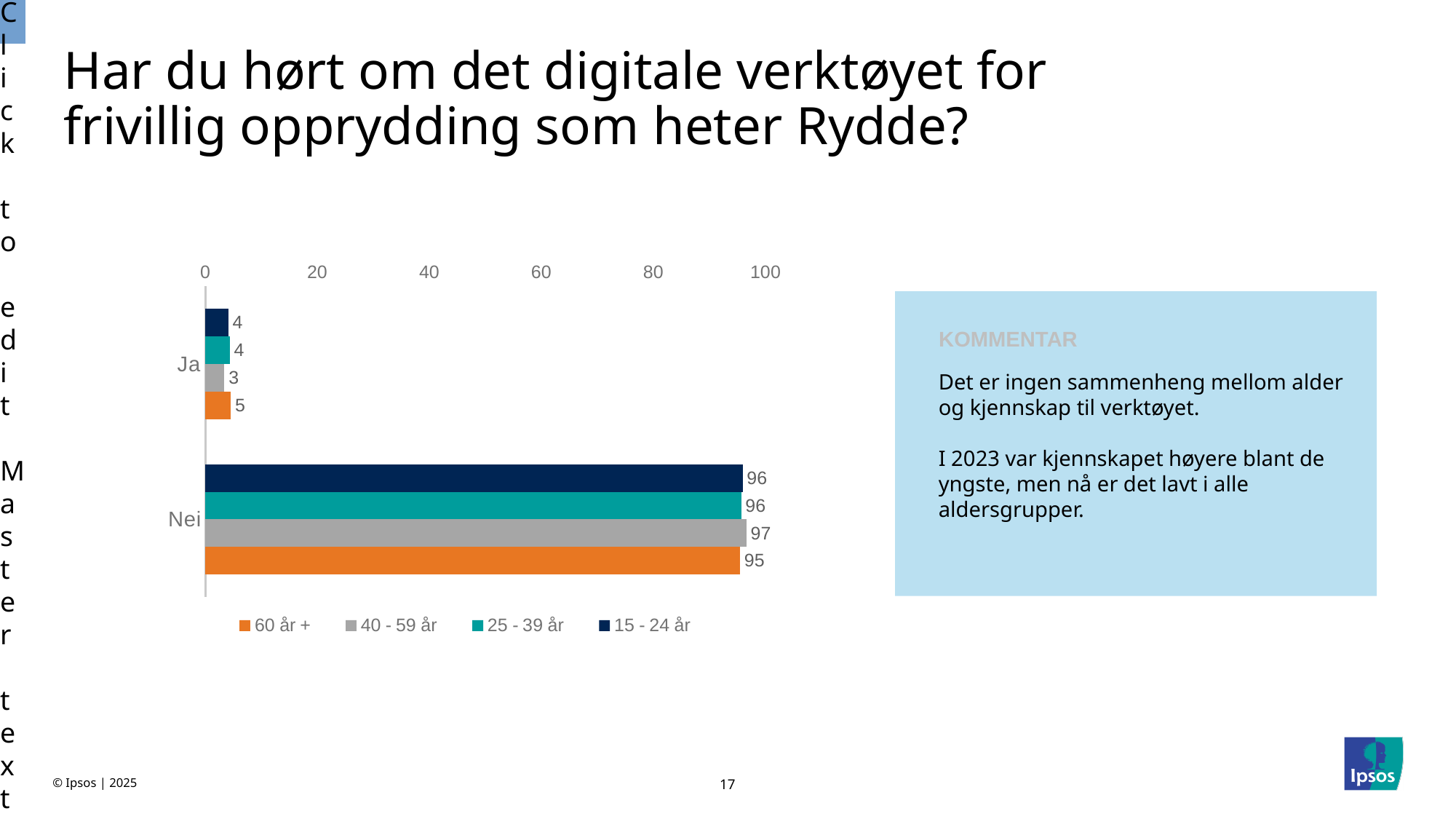
What is the difference between the '40 - 59 år' and '60 år +' values in the 'Nei' category? 2 Which age group has the highest value in the 'Ja' category? 60 år + How many series does the legend list? 4 Which is larger: the '60 år +' value for 'Ja' or the '40 - 59 år' value for 'Ja'? 60 år + How many categories are shown on the vertical axis of the chart? 2 What is the value for '15 - 24 år' in the 'Nei' category? 96 What is the value for '60 år +' in the 'Nei' category? 95 What kind of chart is shown on the slide? Bar chart Which age group has the lowest value in the 'Ja' category? 40 - 59 år Which colour represents the '15 - 24 år' series in the legend? Dark blue What is the value for '40 - 59 år' in the 'Ja' category? 3 What is the value for '25 - 39 år' in the 'Ja' category? 4